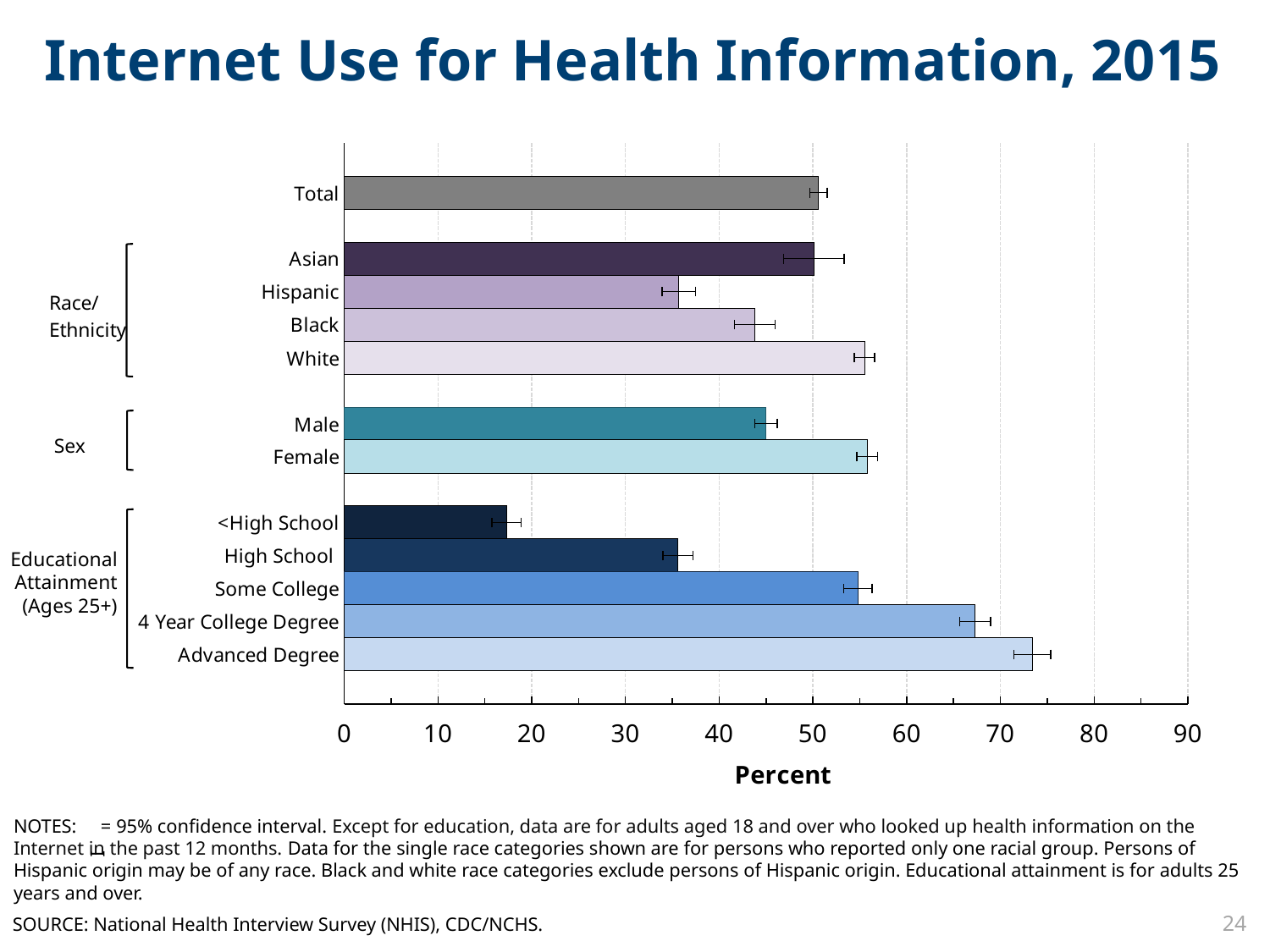
What is the label of the horizontal axis? Percent How many bars are plotted in the chart? 12 Is the value for Advanced Degree greater or less than 70? greater Which is larger, the value for Female or the value for Male? Female Which category has the lowest percentage of Internet use for health information? <High School Is the value for 4 Year College Degree greater or less than 60? greater Which is larger, the value for White or the value for Black? White Is the value for <High School greater or less than 20? less What kind of chart is shown on the slide? bar chart Which category has the highest percentage of Internet use for health information? Advanced Degree